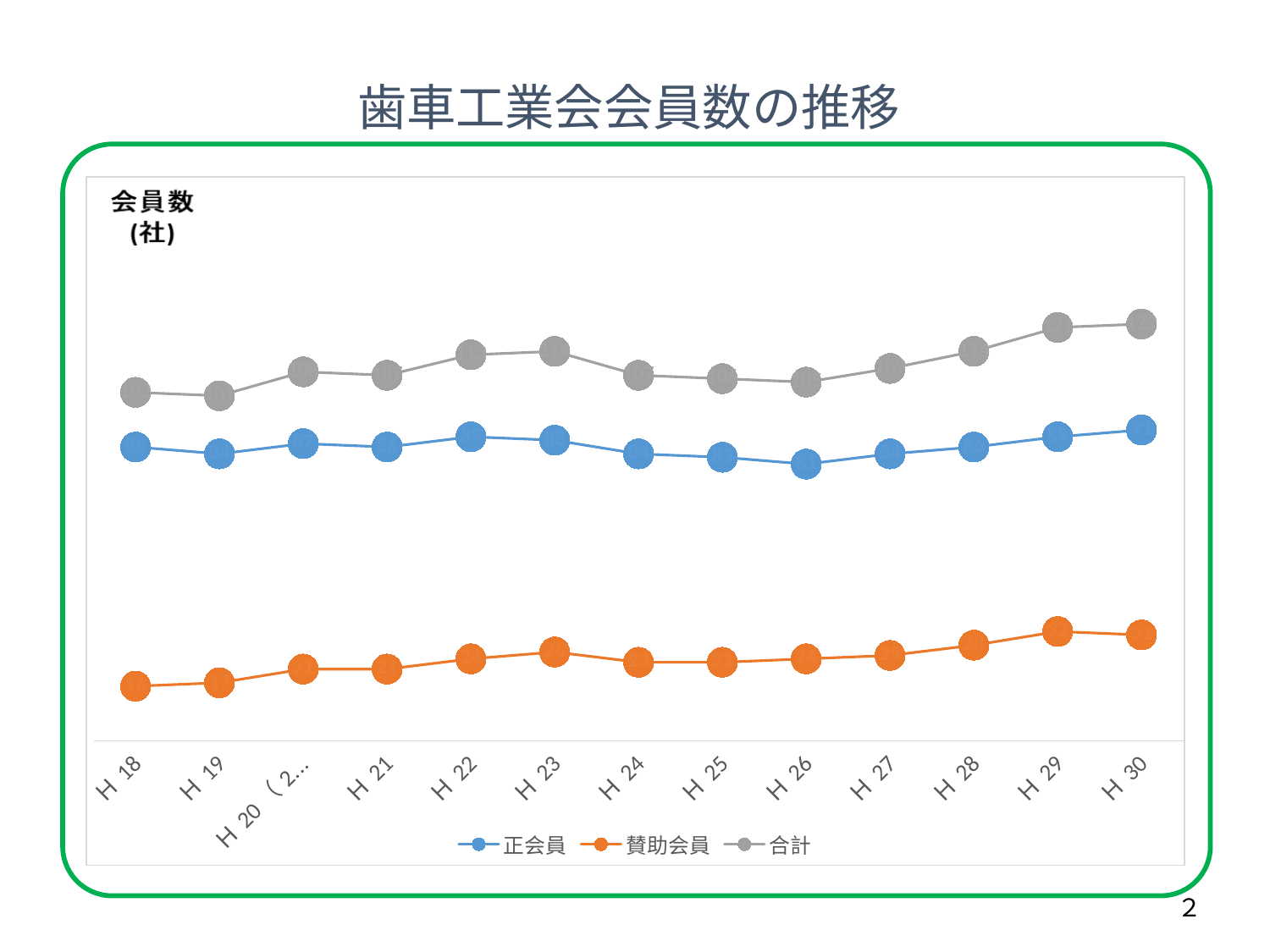
Which series has the highest values across all years? 合計 How many points (years) are plotted along the x axis? 13 Which year has the highest value for 正会員? H 30 What is the title of the slide? 歯車工業会会員数の推移 Does the 賛助会員 series generally rise or fall from H 18 to H 30? rise Does the 合計 series rise or fall from H 26 to H 29? rise How many series does the legend list? 3 What are the three series named in the legend? 正会員, 賛助会員, 合計 Which year has the lowest value for 正会員? H 26 Which series is larger at H 25, 正会員 or 賛助会員? 正会員 What kind of chart is shown on the slide? line chart Which is larger for 正会員, the value at H 22 or the value at H 26? H 22